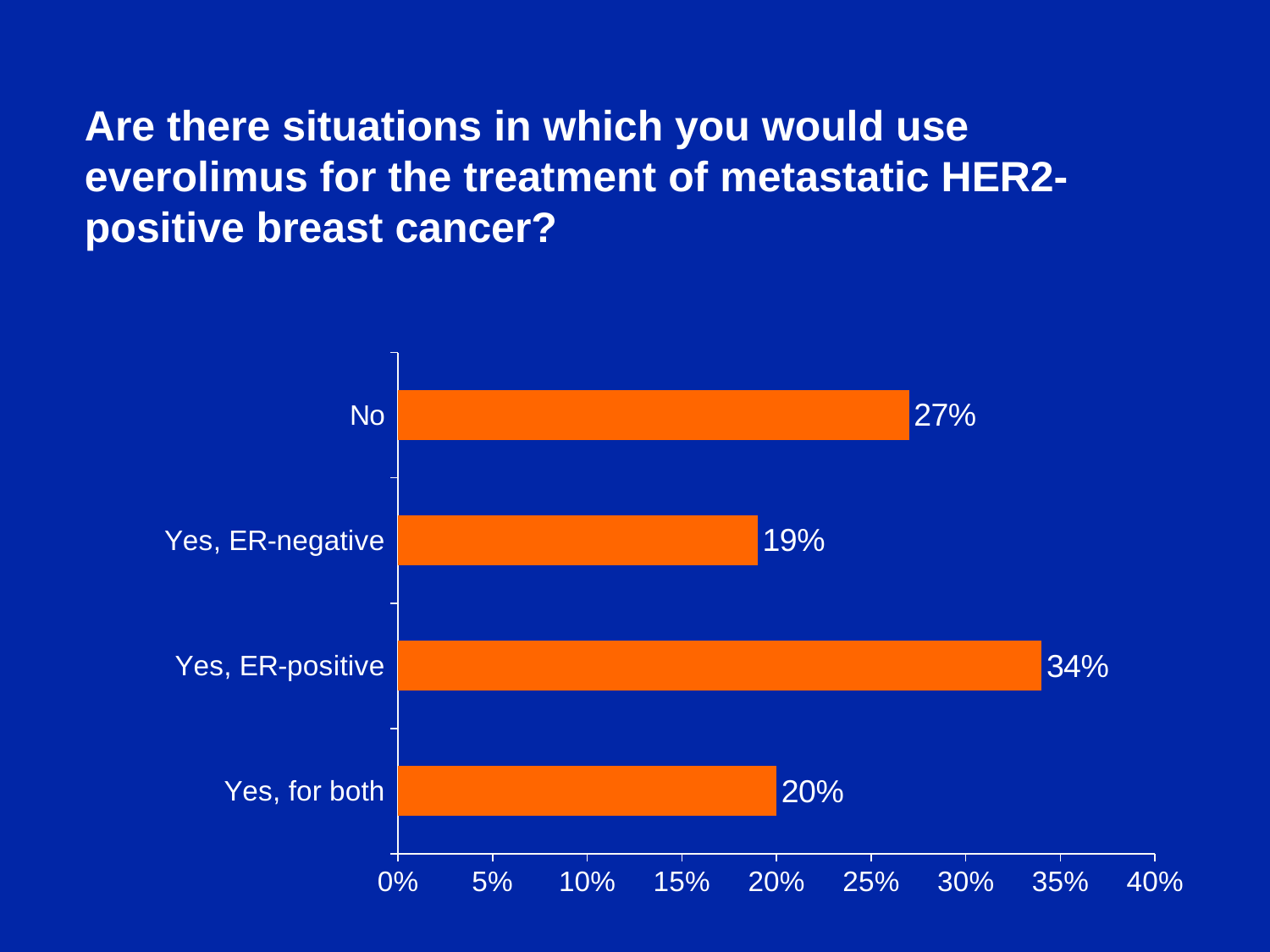
What is the value for "Yes, ER-negative"? 19% How many response categories are shown in the chart? 4 What is the value for "Yes, ER-positive"? 34% Which is larger, the value for "No" or the value for "Yes, for both"? No Which response category has the highest value? Yes, ER-positive Which response category has the lowest value? Yes, ER-negative What is the difference between the values for "Yes, ER-positive" and "No"? 7% Is the value for "Yes, ER-positive" greater or less than 30%? greater What is the value for "Yes, for both"? 20% What percentage of respondents answered "No"? 27% What is the difference between the values for "No" and "Yes, ER-negative"? 8% What kind of chart is shown on the slide? Bar chart